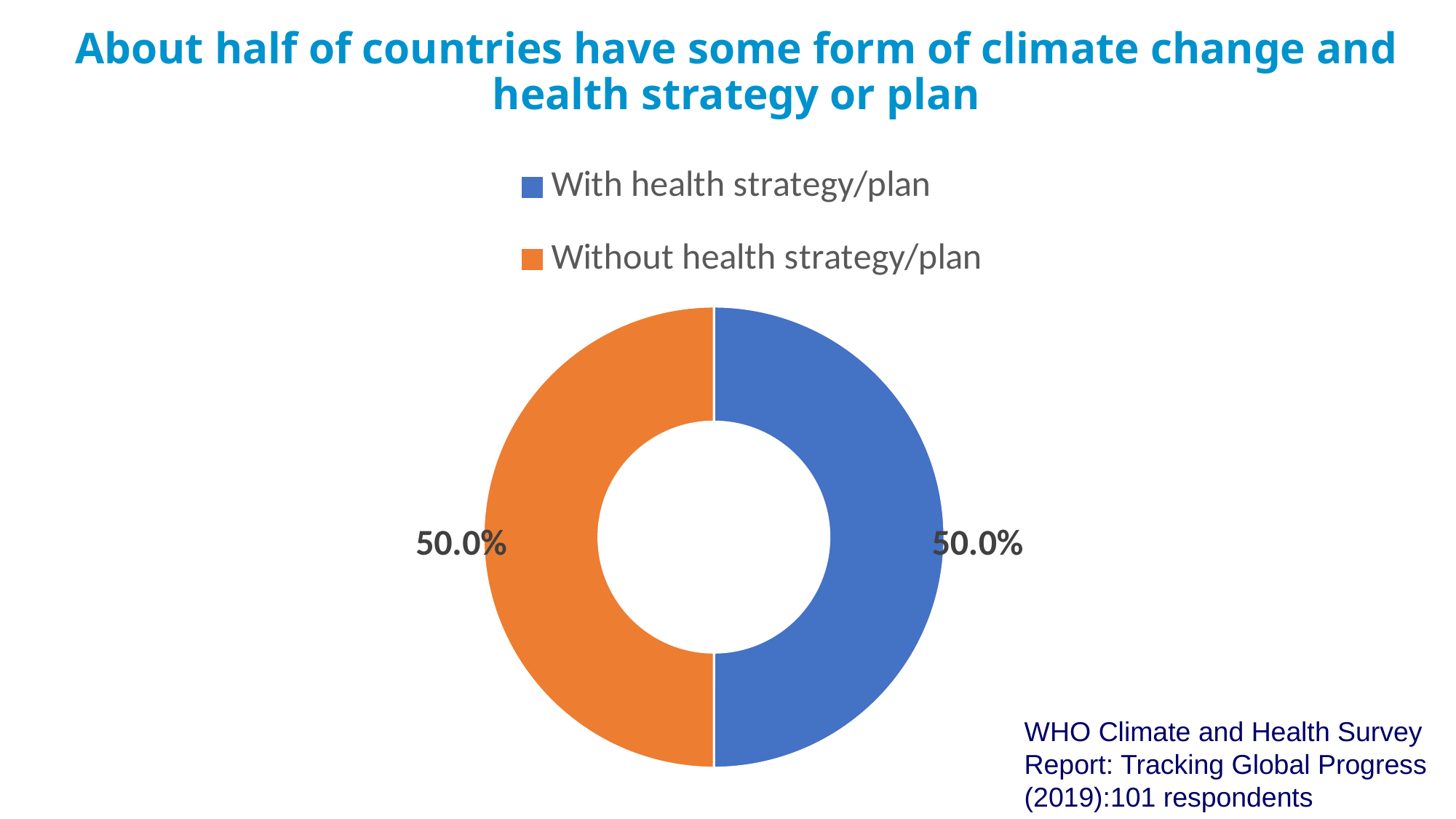
What kind of chart is shown on the slide? Doughnut (pie) chart What percentage of countries are shown as being without a health strategy/plan? 50.0% Is the share of countries with a health strategy/plan greater or less than 40%? greater What is the combined share of the two slices in the chart? 100.0% Which colour represents 'With health strategy/plan' in the chart? Blue How many entries does the legend list? 2 What is the difference between the share with a health strategy/plan and the share without one? 0.0% Which colour represents 'Without health strategy/plan' in the chart? Orange Is the share of countries without a health strategy/plan greater or less than 60%? less What percentage of countries are shown as having a health strategy/plan? 50.0% How many categories does the chart show? 2